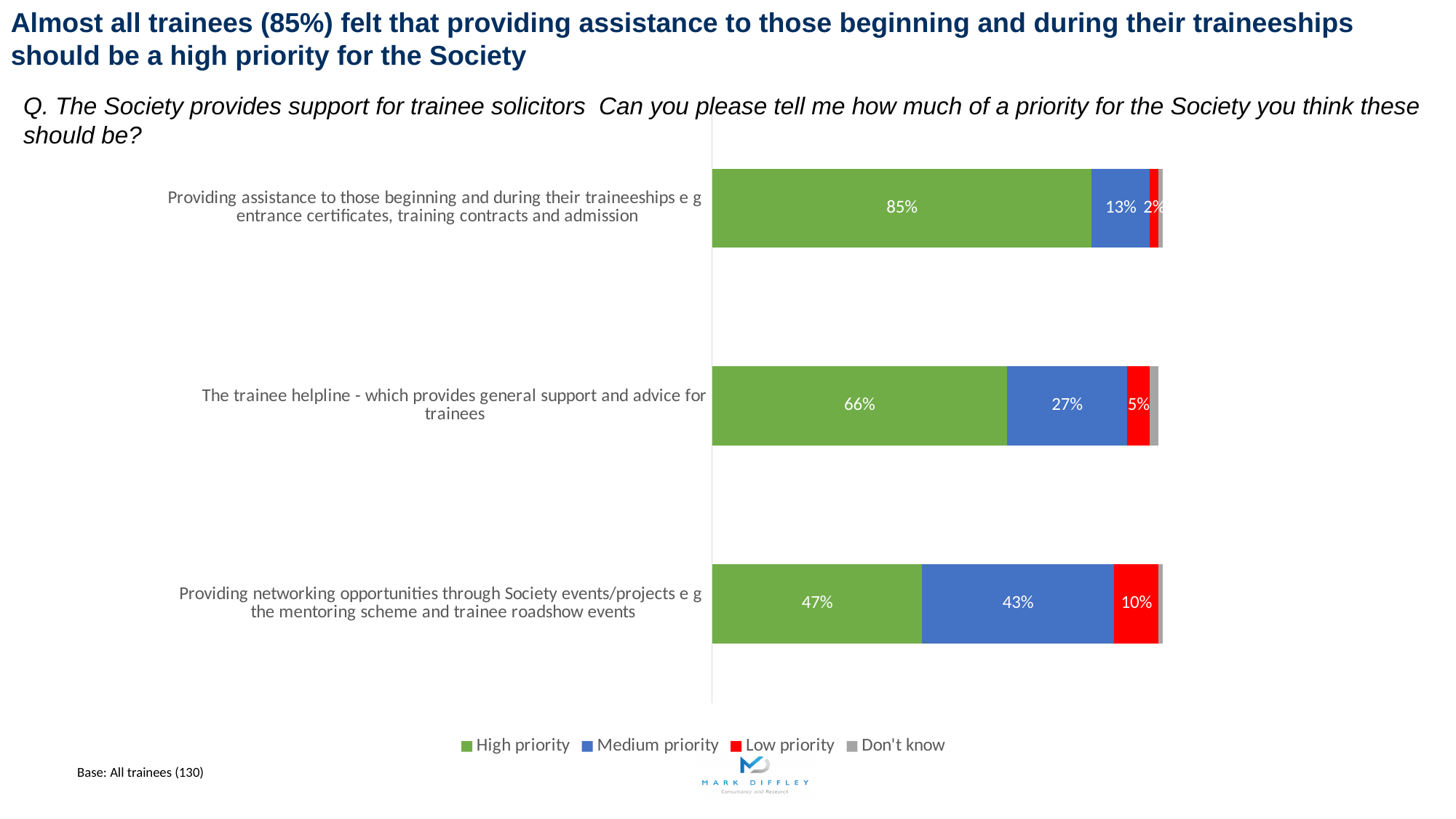
What percentage of trainees rated the trainee helpline as a medium priority? 27% How many support areas are shown in the chart? 3 What type of chart is shown on the slide? Stacked bar chart What percentage of trainees rated providing assistance to those beginning and during their traineeships as a high priority? 85% Which colour represents 'Low priority' in the chart? Red Which is larger: the medium priority share for providing networking opportunities or the medium priority share for the trainee helpline? Providing networking opportunities Which support area has the lowest share of trainees rating it a high priority? Providing networking opportunities through Society events/projects How many series does the legend list? 4 What is the difference in percentage points between the high priority share for providing assistance to those beginning their traineeships (85%) and for the trainee helpline (66%)? 19 Which support area has the highest share of trainees rating it a high priority? Providing assistance to those beginning and during their traineeships What percentage of trainees rated providing networking opportunities through Society events/projects as a low priority? 10% What percentage of trainees rated the trainee helpline as a low priority? 5%